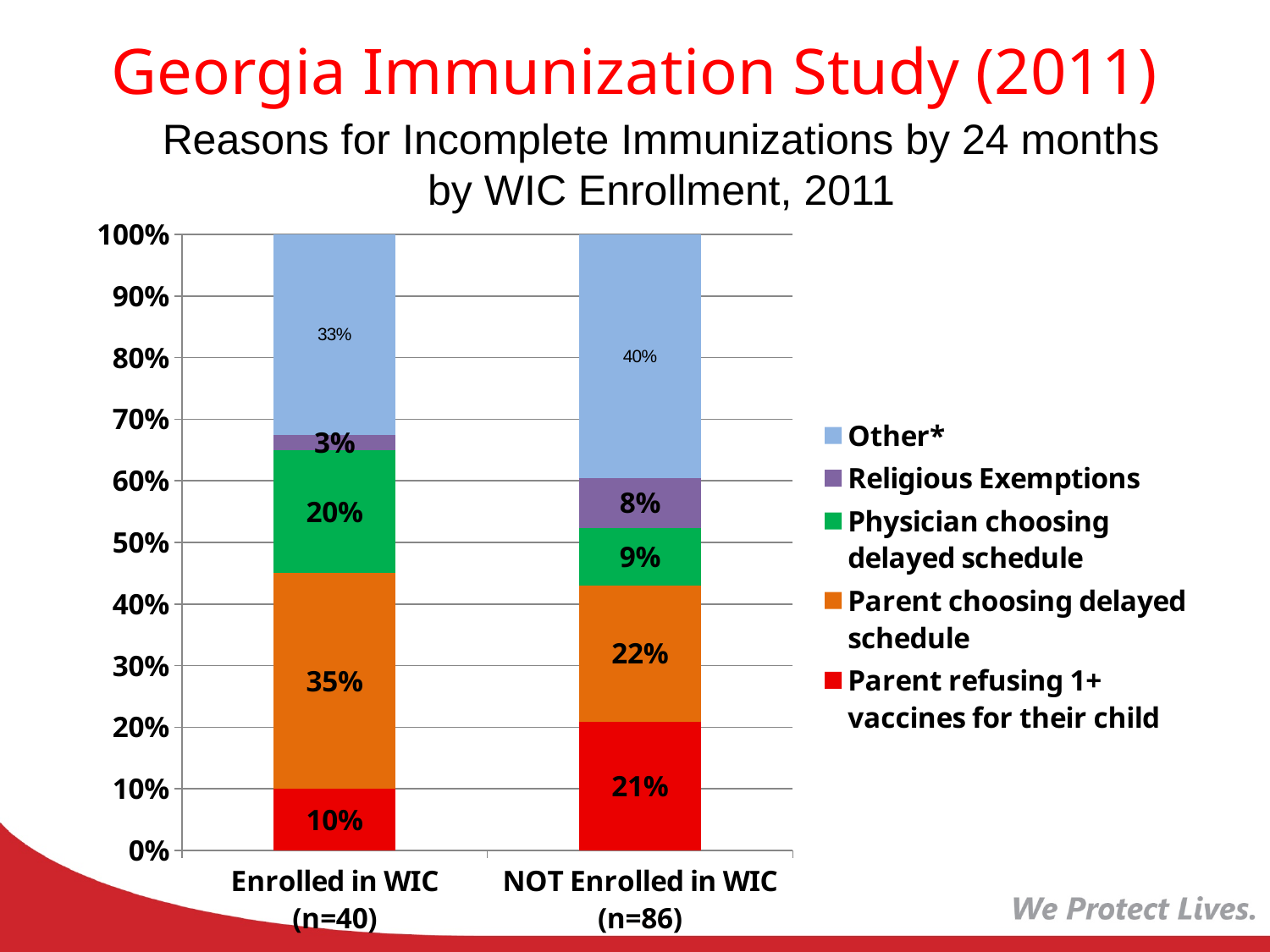
Which reason has the smallest share in the NOT Enrolled in WIC (n=86) bar? Religious Exemptions What is the difference between the Parent choosing delayed schedule values for Enrolled in WIC (n=40) and NOT Enrolled in WIC (n=86)? 13% Which reason has the largest share in the Enrolled in WIC (n=40) bar? Parent choosing delayed schedule What is the value for Other* in the NOT Enrolled in WIC (n=86) bar? 40% Which category has the larger value for Physician choosing delayed schedule, Enrolled in WIC (n=40) or NOT Enrolled in WIC (n=86)? Enrolled in WIC (n=40) What is the value for Parent choosing delayed schedule in the NOT Enrolled in WIC (n=86) bar? 22% What kind of chart is shown on the slide? Stacked bar chart What is the value for Religious Exemptions in the Enrolled in WIC (n=40) bar? 3% How many series does the legend list? 5 What is the value for Parent refusing 1+ vaccines for their child in the Enrolled in WIC (n=40) bar? 10% How many categories are shown on the x axis? 2 What is the title of the chart? Reasons for Incomplete Immunizations by 24 months by WIC Enrollment, 2011